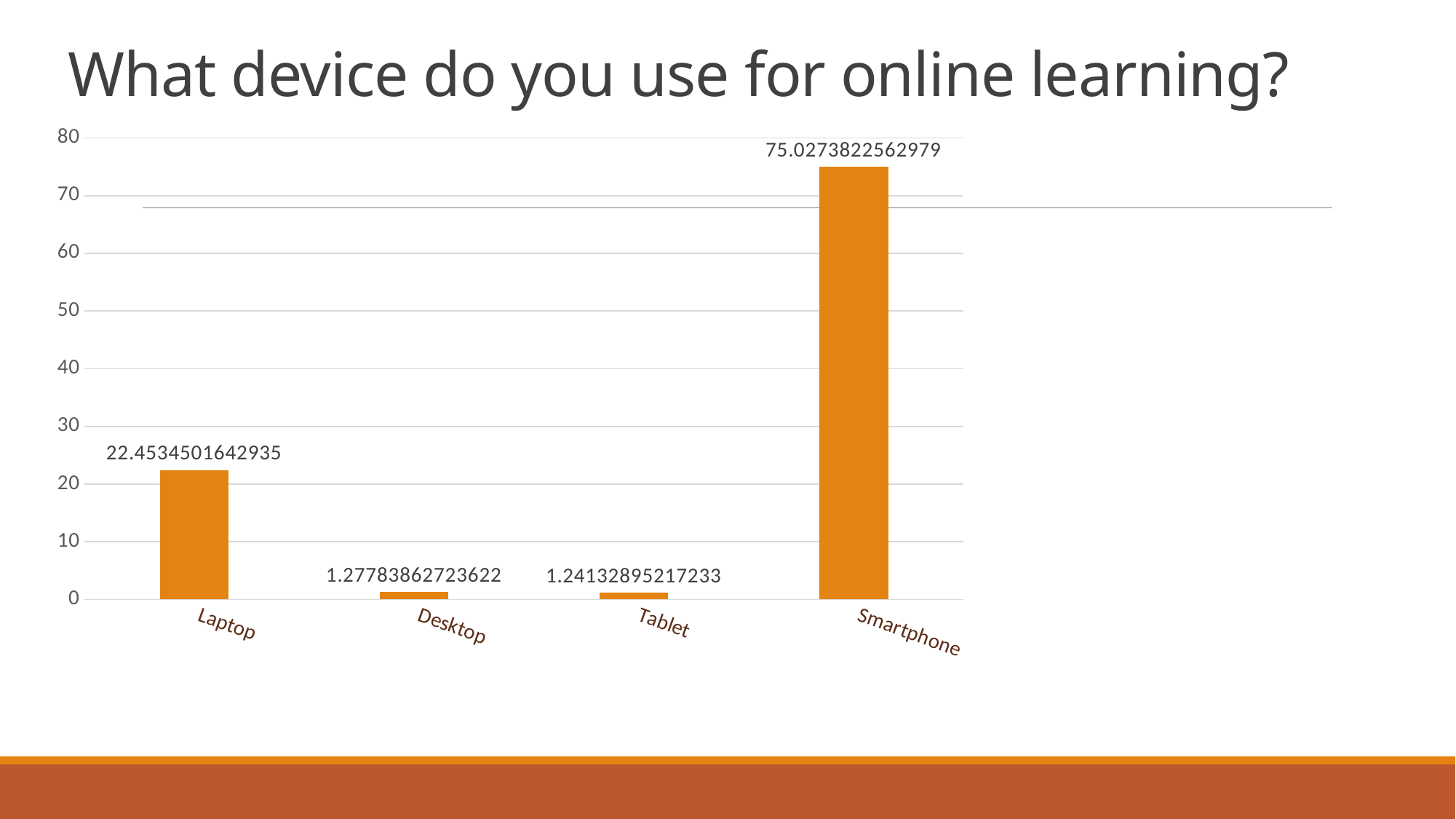
Is the value for Laptop greater or less than 20? greater What kind of chart is shown on the slide? Bar chart What is the value for Tablet? 1.24132895217233 What is the value for Smartphone? 75.0273822562979 Which device has the highest value? Smartphone What is the difference between the values for Smartphone and Laptop? 52.5739320920044 What is the value for Laptop? 22.4534501642935 Which device has the lowest value? Tablet What is the title of the slide? What device do you use for online learning? What is the value for Desktop? 1.27783862723622 How many device categories are shown on the x axis? 4 Which is larger, the value for Desktop or the value for Tablet? Desktop